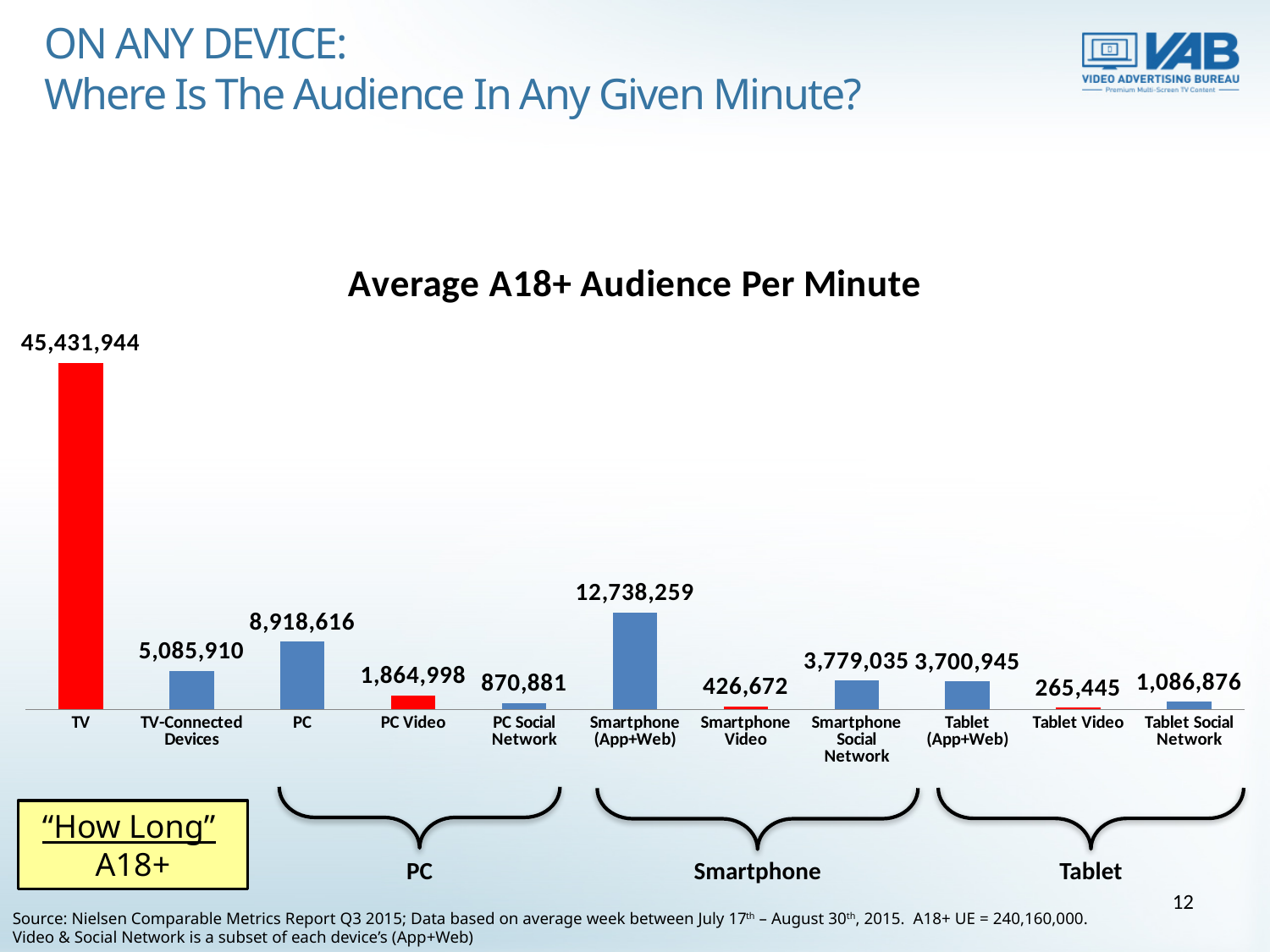
How many categories are shown on the x axis of the chart? 11 What is the title of the chart? Average A18+ Audience Per Minute What is the average A18+ audience per minute for TV? 45,431,944 What is the difference between the PC value and the TV-Connected Devices value? 3,832,706 Which category has the highest average A18+ audience per minute? TV Which is larger, the value for PC Video or the value for Smartphone Video? PC Video What is the value shown for Tablet Social Network? 1,086,876 Which category has the lowest average A18+ audience per minute? Tablet Video What is the value shown for PC Social Network? 870,881 What is the value shown for Smartphone (App+Web)? 12,738,259 What is the difference between the TV value and the Smartphone (App+Web) value? 32,693,685 What type of chart is used on this slide? Bar chart